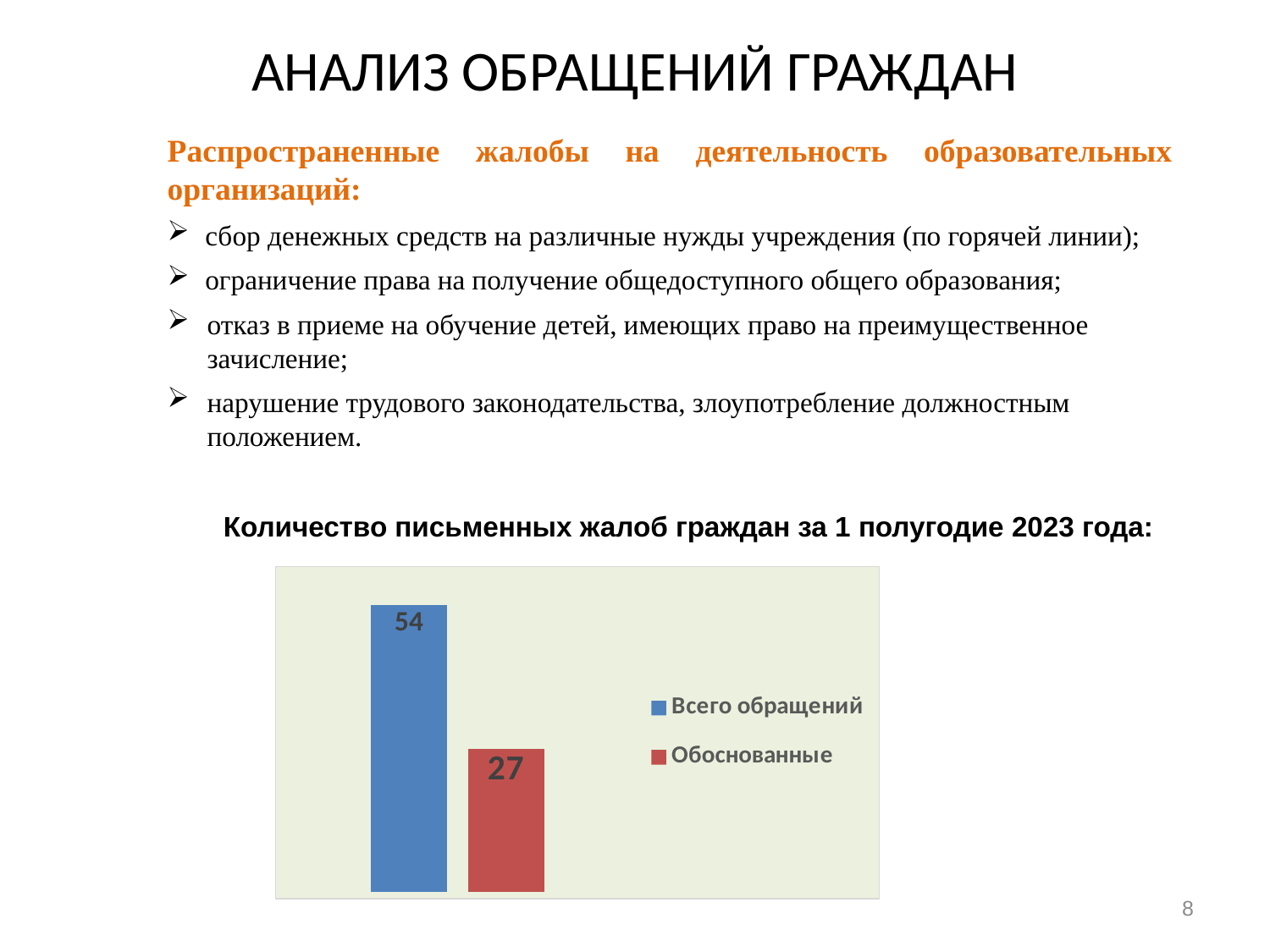
What is the difference between "Всего обращений" and "Обоснованные"? 27 How many series does the legend list? 2 How many bars are plotted in the chart? 2 Which series has the lowest value in the chart? Обоснованные What colour is the bar for "Обоснованные"? Red What is the title above the chart? Количество письменных жалоб граждан за 1 полугодие 2023 года: Which series has the highest value in the chart? Всего обращений What is the value for "Всего обращений" in the chart? 54 Which is larger, "Всего обращений" or "Обоснованные"? Всего обращений What kind of chart is shown on the slide? Bar chart What is the value for "Обоснованные" in the chart? 27